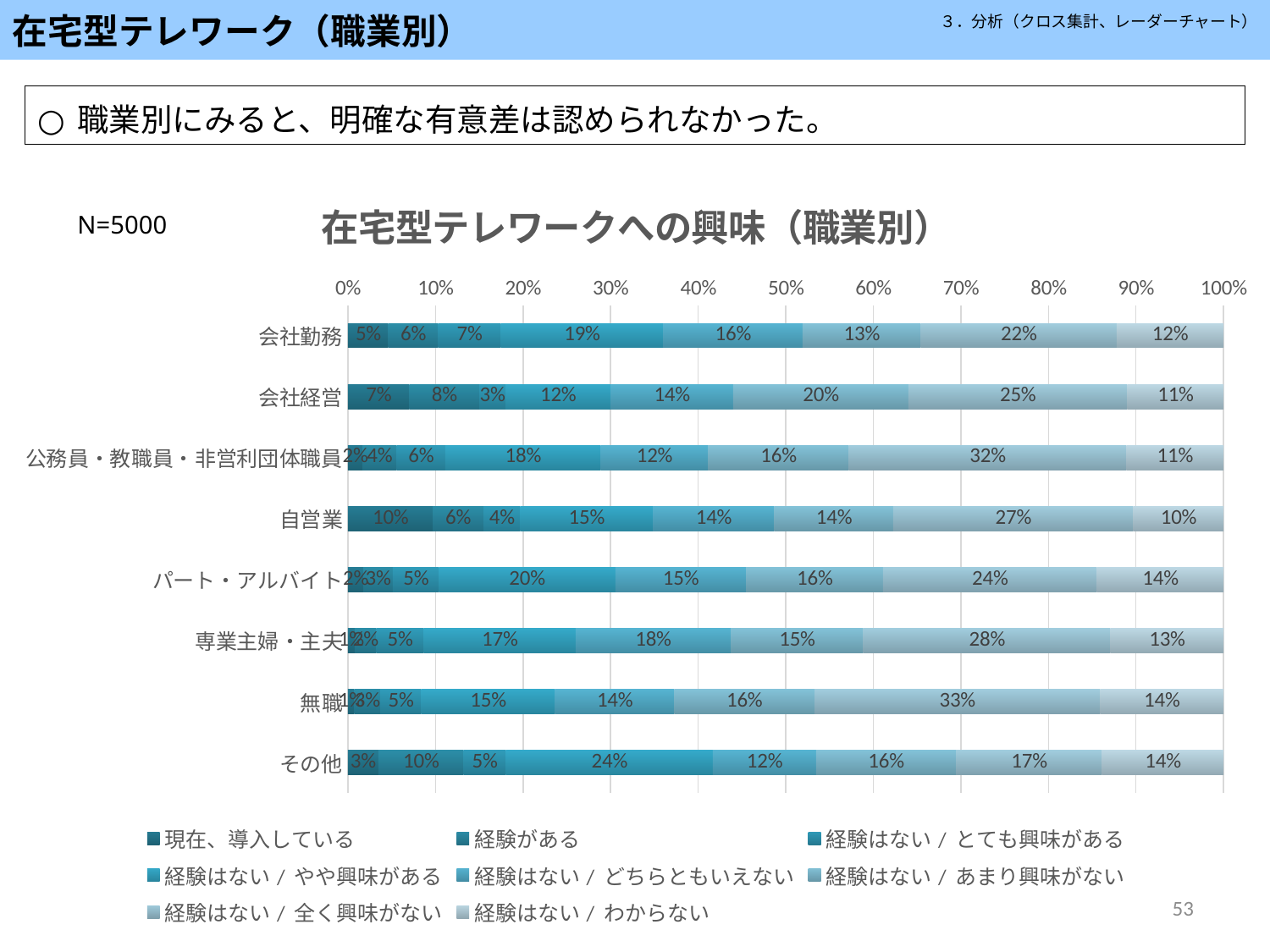
What is the value of 経験はない / あまり興味がない for 会社経営? 20% What is the difference between the 経験はない / 全く興味がない values for 公務員・教職員・非営利団体職員 and 会社勤務? 10% How many occupation categories are plotted in the chart? 8 What type of chart is shown on the slide? stacked bar chart What is the value of 現在、導入している for 自営業? 10% What is the value of 経験はない / やや興味がある for その他? 24% What is the value of 経験はない / 全く興味がない for 無職? 33% Which is larger: the 経験がある value for その他 or for 会社経営? その他 What is the title of the chart? 在宅型テレワークへの興味（職業別） Which occupation has the highest value for 経験はない / 全く興味がない? 無職 How many series does the legend list? 8 Which occupation has the lowest value for 経験はない / 全く興味がない? その他